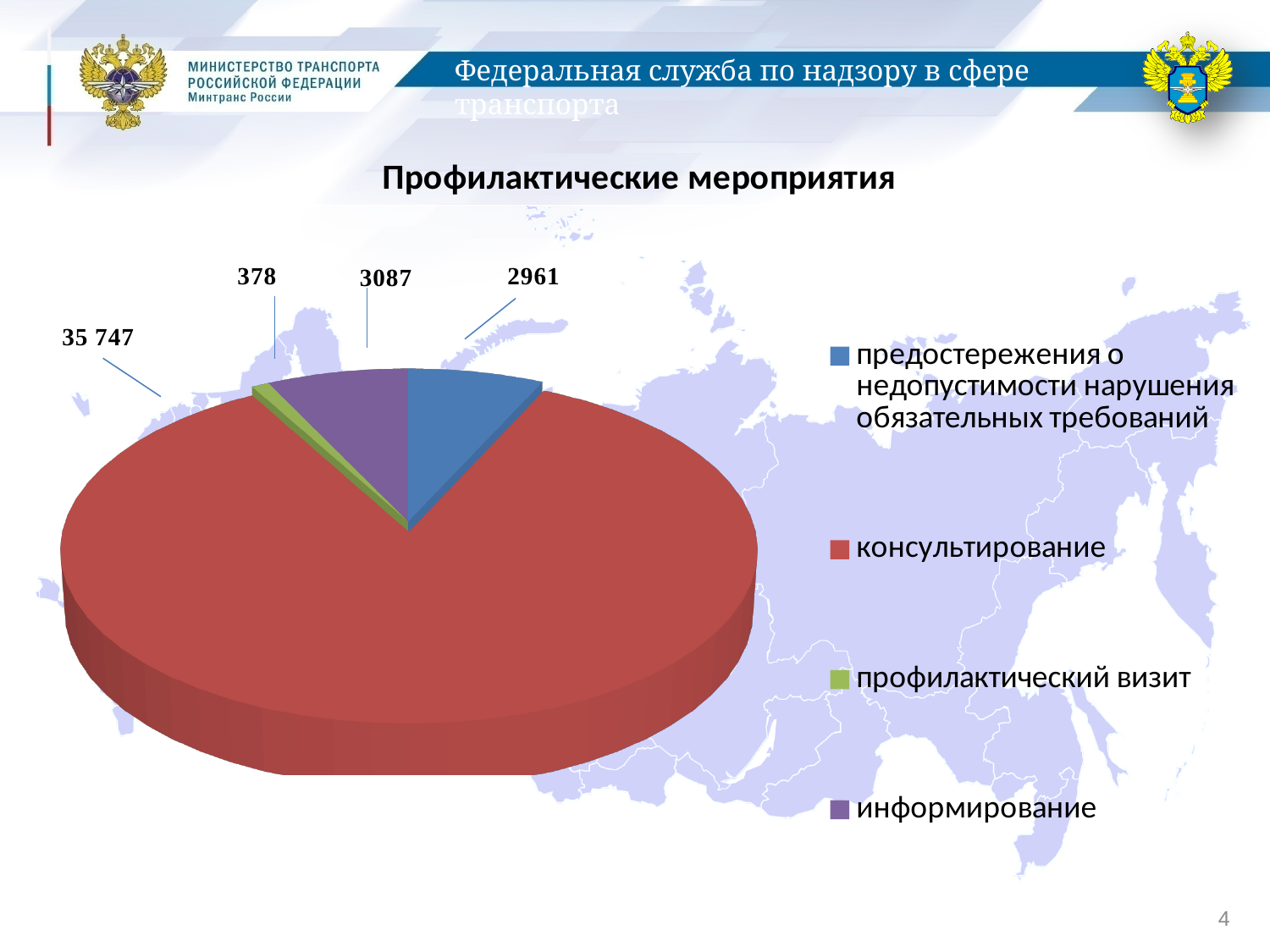
What type of chart is shown on the slide? pie chart Which category has the smallest slice of the pie? профилактический визит How many slices does the pie chart have? 4 What is the difference between the values for информирование and предостережения о недопустимости нарушения обязательных требований? 126 What is the value for информирование? 3087 Which category has the largest slice of the pie? консультирование What is the value for консультирование? 35 747 What is the value for профилактический визит? 378 What is the difference between the values for консультирование and информирование? 32 660 What colour is the slice for консультирование? red Which is larger, the value for информирование or the value for профилактический визит? информирование What is the value for предостережения о недопустимости нарушения обязательных требований? 2961